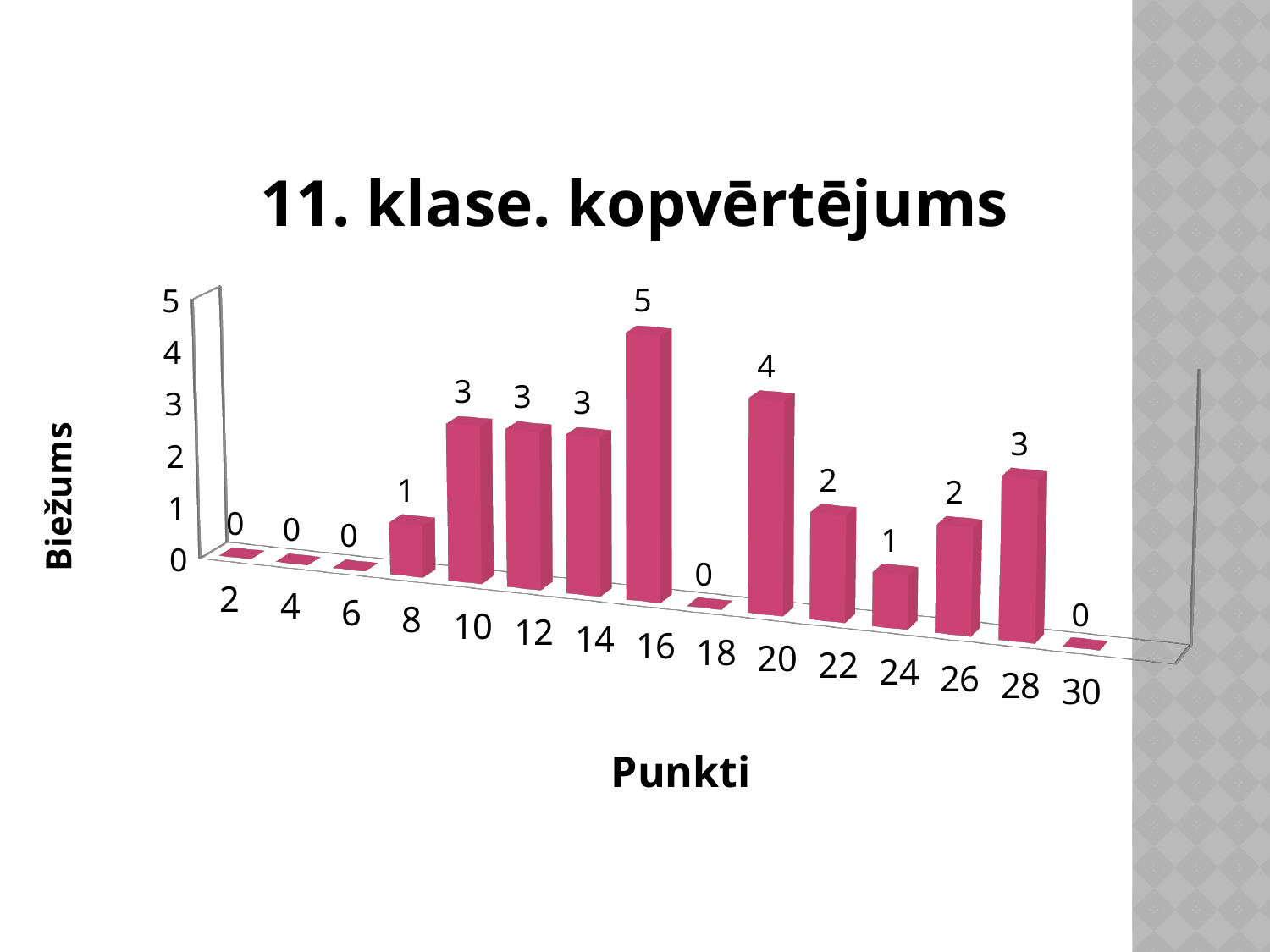
What is the value for 16 points? 5 What is the value for 24 points? 1 What is the value for 20 points? 4 Which is larger, the value for 22 points or the value for 28 points? 28 Which points category has the highest frequency? 16 What is the value for 28 points? 3 What is the title of the chart? 11. klase. kopvērtējums What kind of chart is shown? bar chart What is the difference between the values for 16 and 20 points? 1 What is the total of the values for 10, 12 and 14 points? 9 How many points categories are shown on the x axis? 15 What is the label of the x axis? Punkti